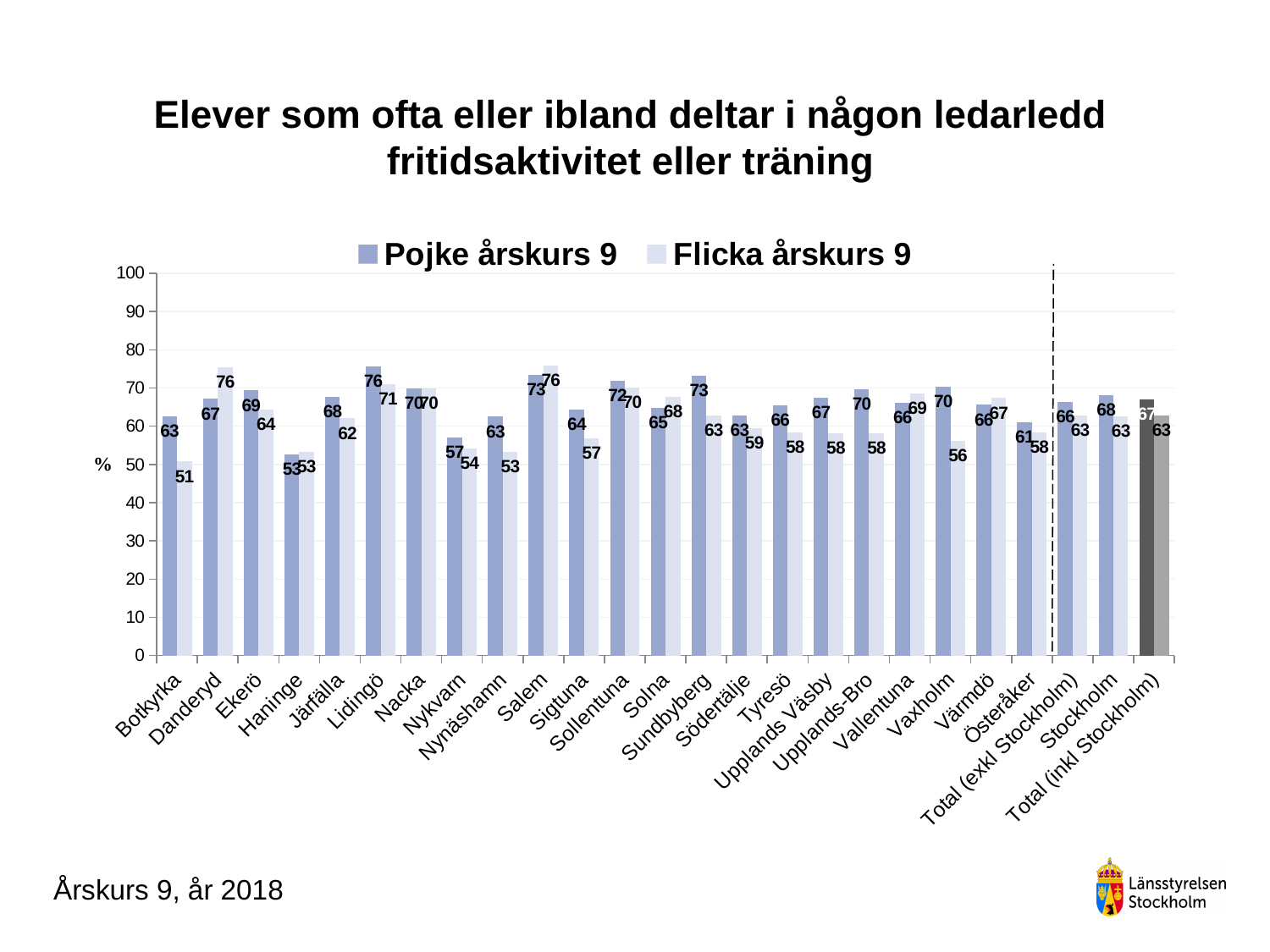
Which municipality has the highest value for Pojke årskurs 9? Lidingö What is the value for Flicka årskurs 9 in Botkyrka? 51 How many series does the legend list? 2 In Danderyd, which is larger: the value for Pojke årskurs 9 or Flicka årskurs 9? Flicka årskurs 9 What is the difference between the Pojke årskurs 9 and Flicka årskurs 9 values in Vaxholm? 14 How many categories are shown on the x axis? 25 What is the value for Pojke årskurs 9 in Lidingö? 76 What kind of chart is shown on the slide? Bar chart Which municipality has the lowest value for Pojke årskurs 9? Haninge What is the value for Flicka årskurs 9 in Danderyd? 76 What is the value for Pojke årskurs 9 for Total (inkl Stockholm)? 67 Which municipality has the lowest value for Flicka årskurs 9? Botkyrka